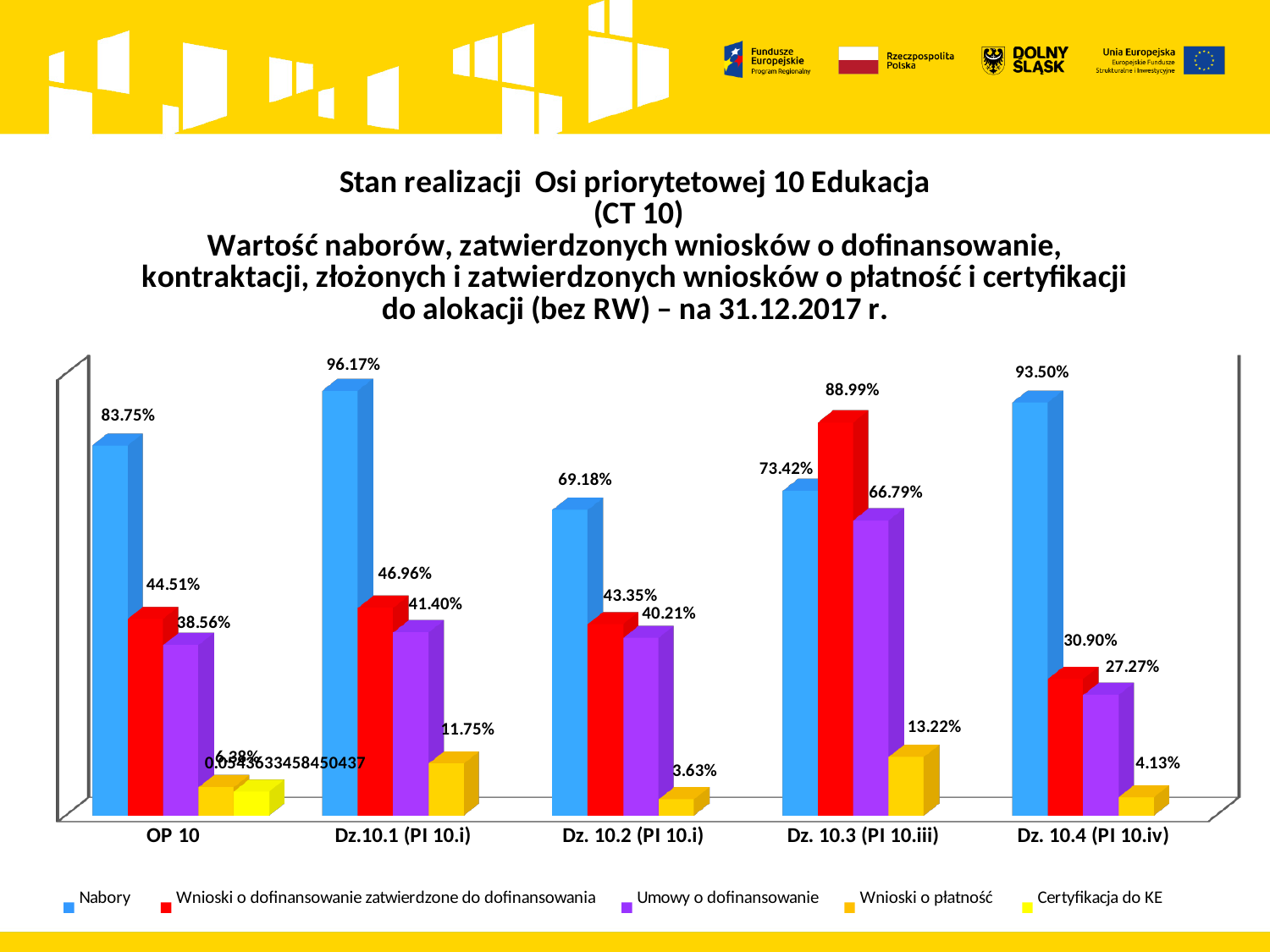
How many categories are shown on the x axis? 5 Which category has the highest Nabory value? Dz.10.1 (PI 10.i) What is the difference between the Nabory value and the Umowy o dofinansowanie value for Dz. 10.3 (PI 10.iii)? 6.63% Which category has the lowest Nabory value? Dz. 10.2 (PI 10.i) What is the value of Wnioski o płatność for Dz. 10.2 (PI 10.i)? 3.63% Which series is shown in blue in the legend? Nabory For Dz. 10.3 (PI 10.iii), which is larger: Nabory or Wnioski o dofinansowanie zatwierdzone do dofinansowania? Wnioski o dofinansowanie zatwierdzone do dofinansowania What is the value of Umowy o dofinansowanie for Dz. 10.4 (PI 10.iv)? 27.27% What kind of chart is shown on the slide? Bar chart What is the value of Wnioski o dofinansowanie zatwierdzone do dofinansowania for Dz. 10.3 (PI 10.iii)? 88.99% How many series does the legend list? 5 What is the value of Nabory for Dz.10.1 (PI 10.i)? 96.17%